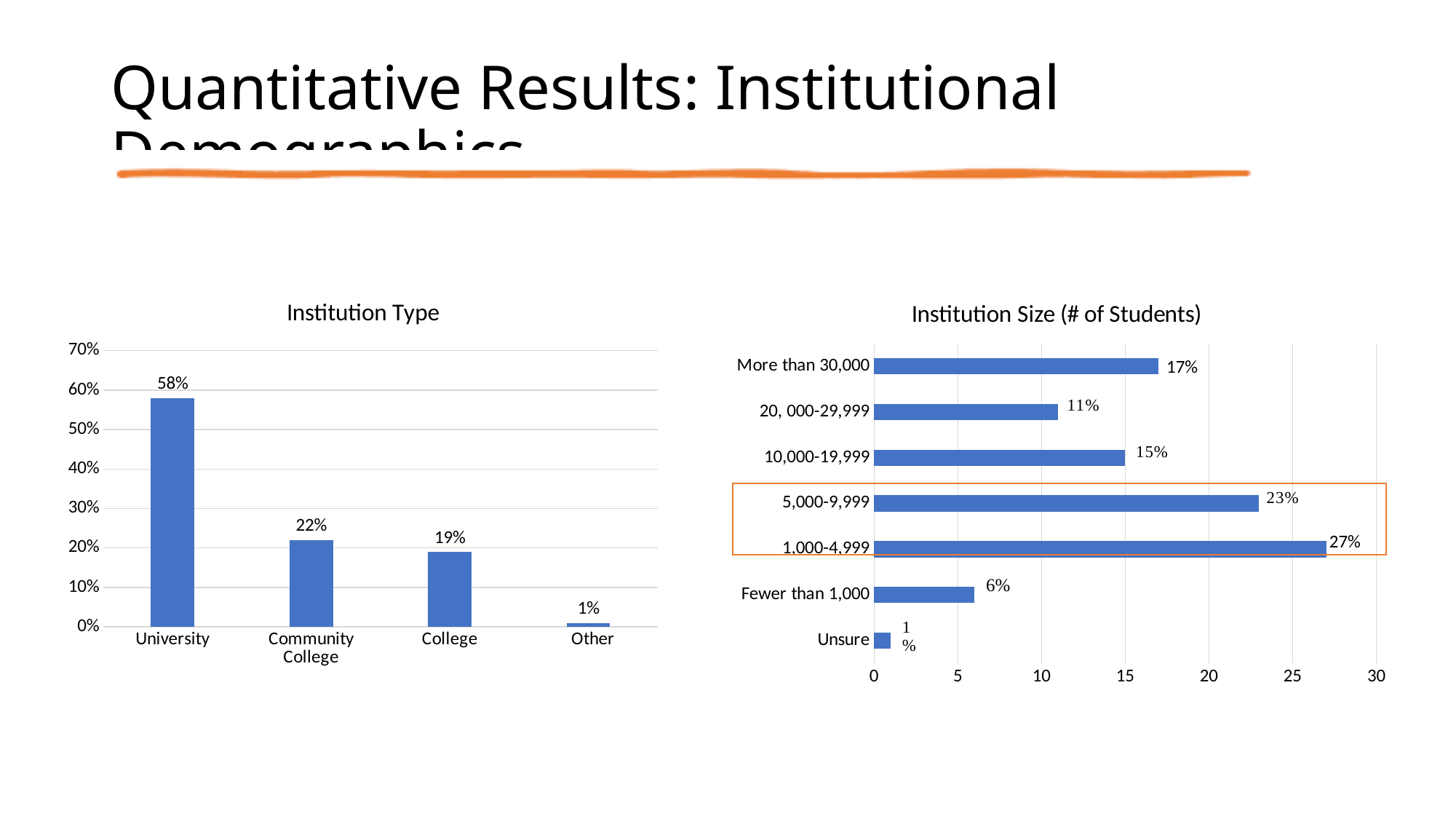
In the Institution Size (# of Students) chart, what is the value for Fewer than 1,000? 6% In the Institution Type chart, what is the value for University? 58% In the Institution Size (# of Students) chart, which is larger: More than 30,000 or 10,000-19,999? More than 30,000 In the Institution Type chart, what is the difference between the values for University and College? 39 percentage points In the Institution Size (# of Students) chart, which category has the highest value? 1,000-4,999 In the Institution Size (# of Students) chart, what is the value for 5,000-9,999? 23% In the Institution Size (# of Students) chart, what is the difference between the values for 1,000-4,999 and 20, 000-29,999? 16 percentage points In the Institution Type chart, which category has the lowest value? Other In the Institution Type chart, how many categories are shown? 4 In the Institution Size (# of Students) chart, how many categories are shown? 7 What kind of chart is the Institution Type chart? Bar chart In the Institution Type chart, what is the value for Community College? 22%